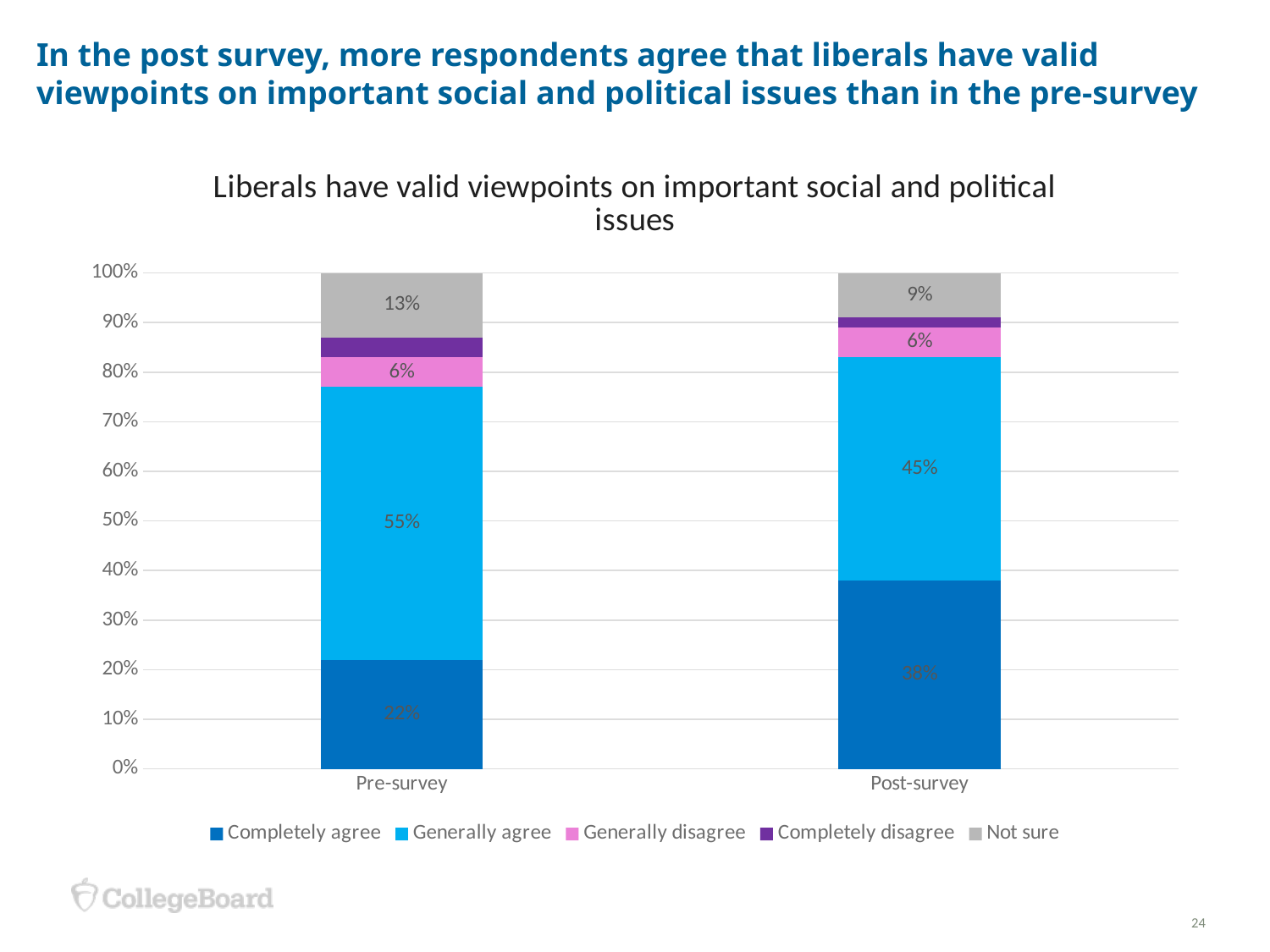
Which series is the largest segment in the Post-survey bar? Generally agree Which category has the larger Generally agree value, Pre-survey or Post-survey? Pre-survey How many series does the legend list? 5 What is the value for Not sure in the Pre-survey bar? 13% How many categories are shown on the x axis? 2 What kind of chart is shown on the slide? stacked bar chart Is the Completely disagree value for Pre-survey greater or less than 10%? less What is the value for Completely agree in the Post-survey bar? 38% What is the value for Generally agree in the Pre-survey bar? 55% What is the value for Generally disagree in the Post-survey bar? 6% What is the difference between the Completely agree values for Post-survey and Pre-survey? 16% What is the title of the chart? Liberals have valid viewpoints on important social and political issues